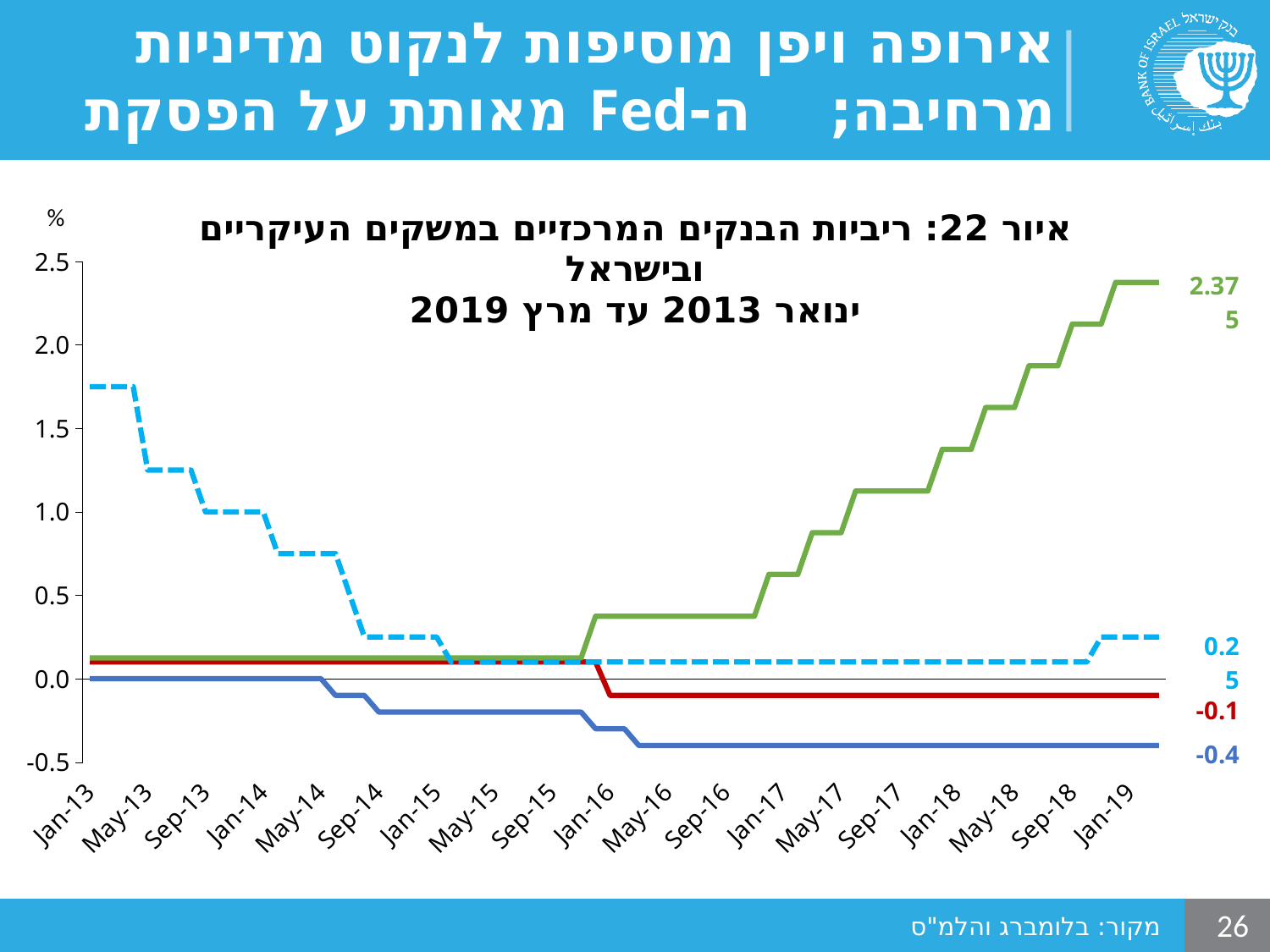
Does the green line rise or fall between Jan-16 and Jan-19? rises How many lines are plotted on the chart? 4 What is the final value shown for the red line at the right edge of the chart? -0.1 What is the final value shown for the dashed light-blue line at the right edge of the chart? 0.25 What kind of chart is shown on the slide? line chart What is the difference between the final values of the green line and the dark-blue line? 2.775 What is the final value shown for the green line at the right edge of the chart? 2.375 What unit is shown on the y axis of the chart? % Which line has the highest value at the end of the period? the green line What is the final value shown for the dark-blue line at the right edge of the chart? -0.4 Which line has the lowest value at the end of the period? the dark-blue line Is the value of the dashed light-blue line in Jan-13 greater or less than 1.5? greater